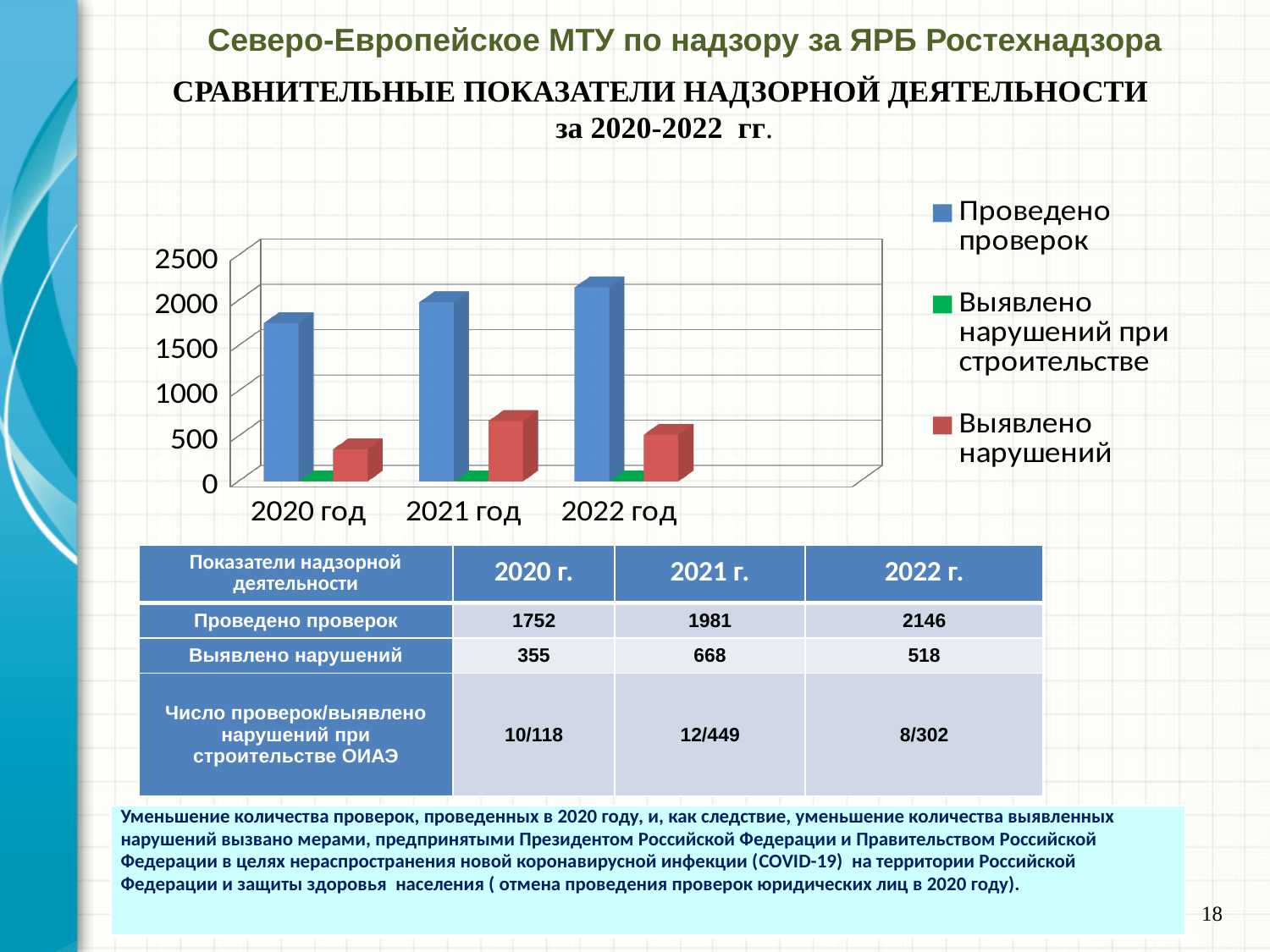
Does the Проведено проверок series rise or fall from 2020 год to 2022 год? rise How many series does the chart legend list? 3 Is the value for Проведено проверок in 2022 год greater or less than 2000? greater Which year has the lowest value for Выявлено нарушений? 2020 год What is the value of Проведено проверок for 2021 год? 1981 What kind of chart is shown on the slide? bar chart How many year categories are shown on the x axis of the chart? 3 What colour are the bars for Выявлено нарушений in the chart? red Which year has the highest value for Проведено проверок? 2022 год Which is larger: Выявлено нарушений in 2021 год or in 2022 год? 2021 год What is the difference between Проведено проверок in 2022 год and 2020 год? 394 What is the value of Выявлено нарушений for 2020 год? 355